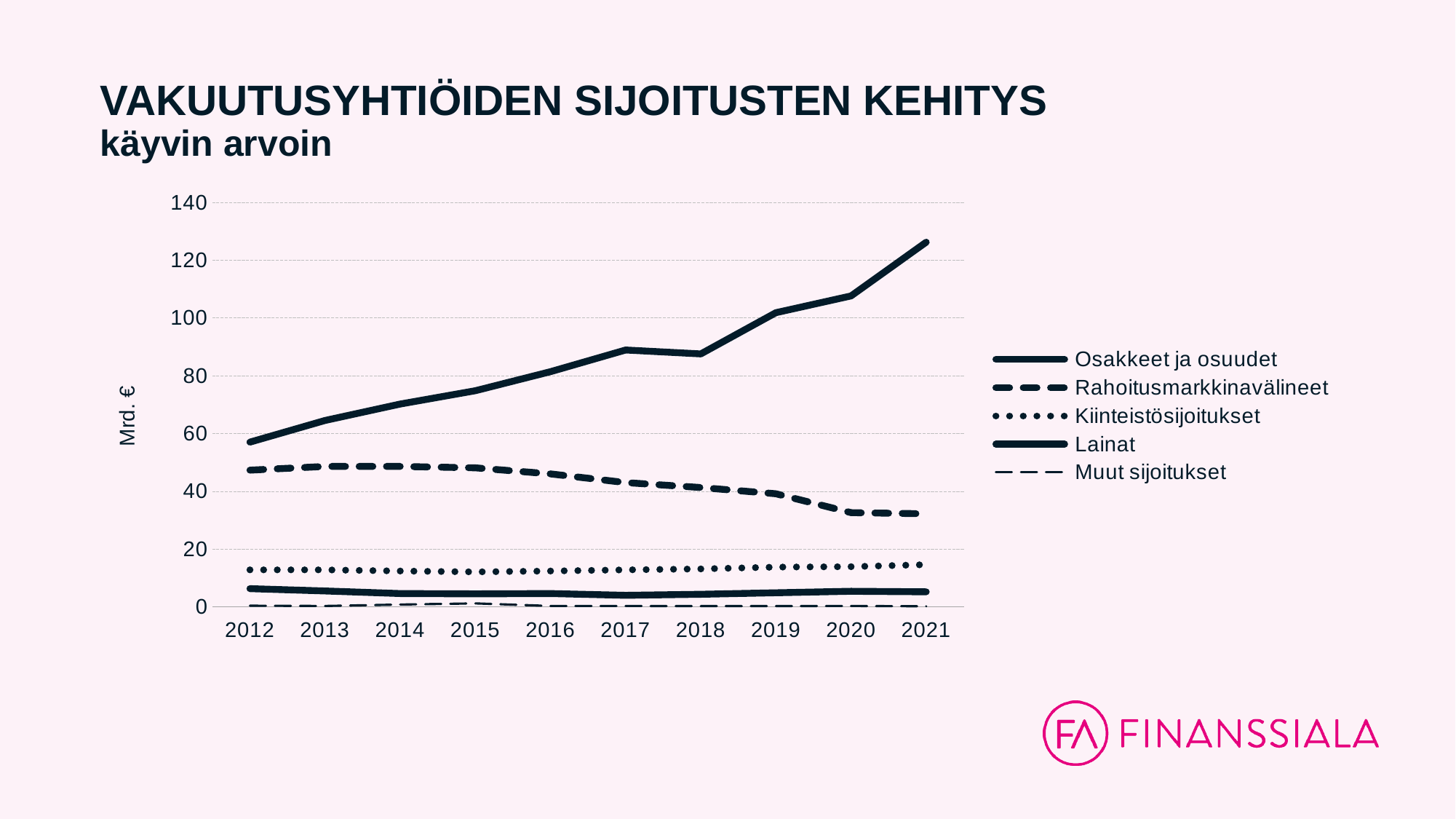
Is the value for Rahoitusmarkkinavälineet in 2021 greater or less than 40? less What kind of chart is shown on the slide? line chart What is the label on the y axis? Mrd. € Is the value for Kiinteistösijoitukset in 2012 greater or less than 20? less How many series does the legend list? 5 In 2021, which is larger: Osakkeet ja osuudet or Rahoitusmarkkinavälineet? Osakkeet ja osuudet Is the value for Osakkeet ja osuudet in 2017 greater or less than 80? greater Does the Rahoitusmarkkinavälineet line rise or fall from 2012 to 2021? fall Does the Osakkeet ja osuudet line rise or fall from 2012 to 2021? rise Which series has the lowest values across all years? Muut sijoitukset How many years are shown on the x axis? 10